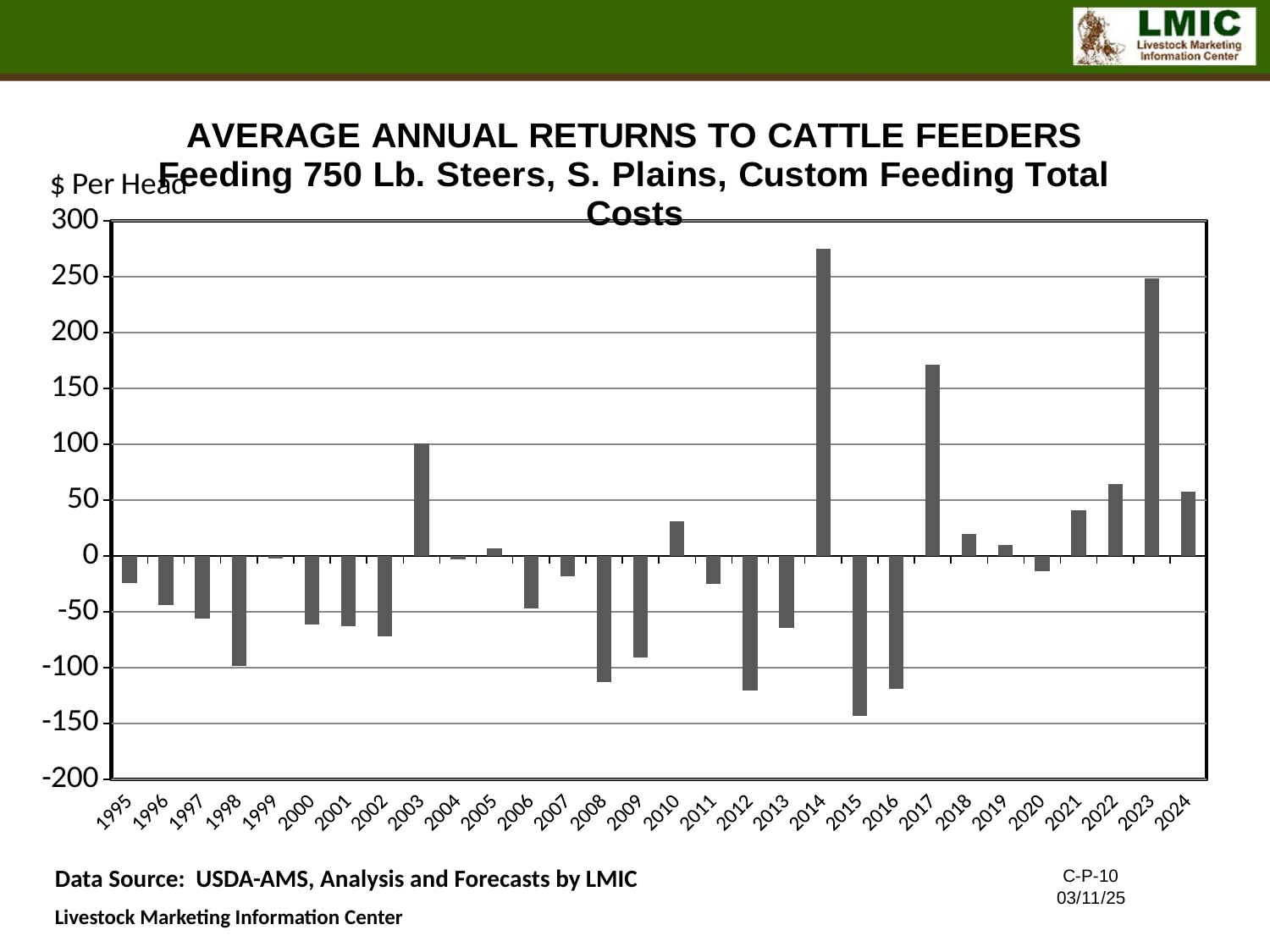
Is the value for 1998 greater or less than -50? less Which year has the lowest average annual return? 2015 What kind of chart is shown on the slide? bar chart Is the value for 2015 greater or less than -100? less Is the value for 2014 greater or less than 250? greater Do the values rise or fall from 2020 to 2023? rise Which year has the highest average annual return? 2014 Which year has the larger return, 2017 or 2023? 2023 What unit is shown on the y axis label? $ Per Head Which year has the larger return, 2014 or 2023? 2014 How many years are plotted along the x axis? 30